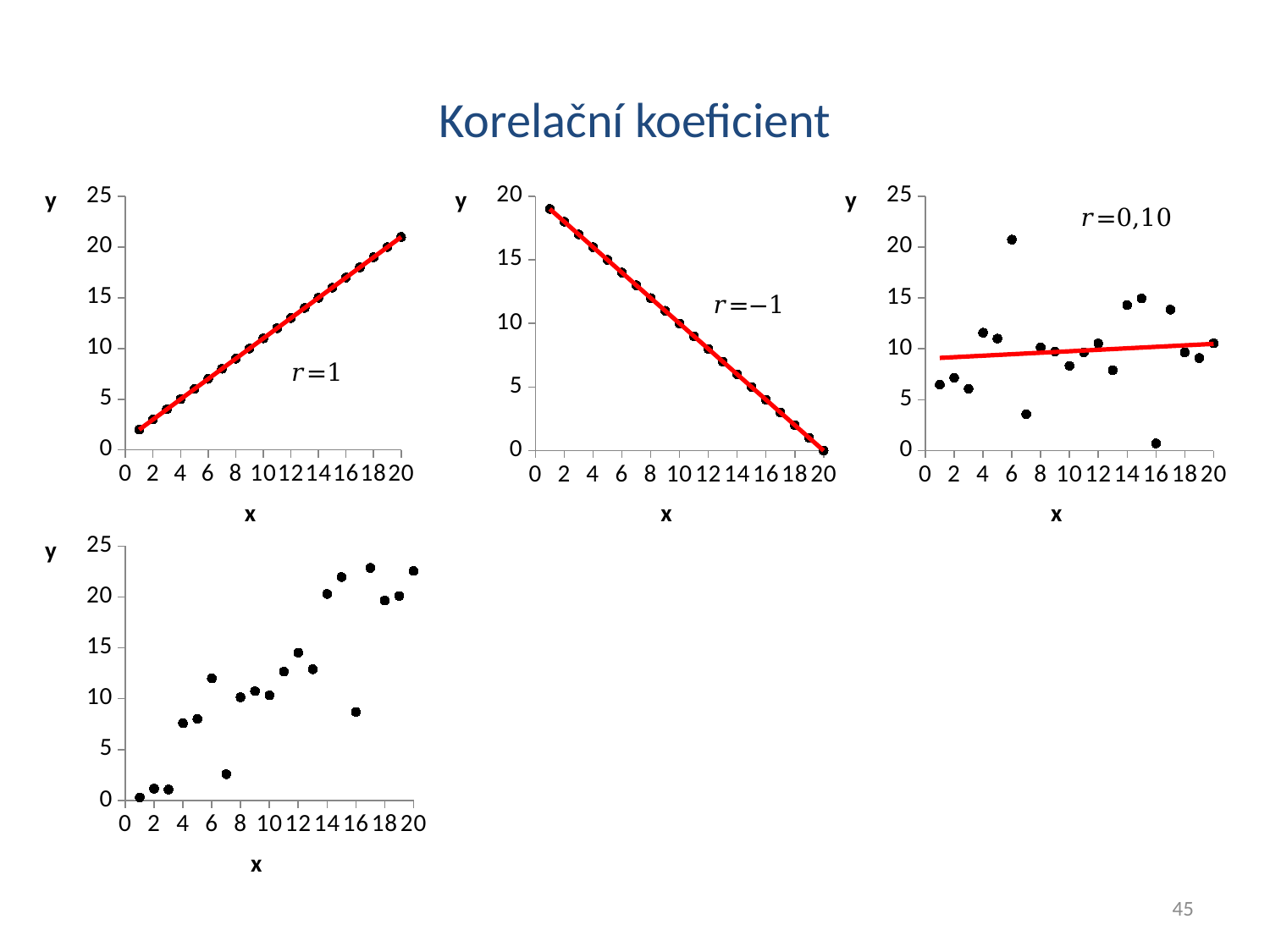
What correlation coefficient is annotated on the top-middle chart? r=−1 In the top-left chart (labelled r=1), do the y values rise or fall as x increases? rise In the bottom-left chart, is the y value at x=17 greater or less than 20? greater In the top-right chart (labelled r=0,10), is the y value at x=6 greater or less than 15? greater In the top-right chart (labelled r=0,10), at which x value is y lowest? 16 In the bottom-left chart, is the y value at x=16 greater or less than 15? less What kind of chart is the top-left chart (labelled r=1)? scatter chart In the top-middle chart (labelled r=−1), do the y values rise or fall as x increases? fall In the bottom-left chart, which has the larger y value: the point at x=6 or the point at x=7? x=6 What correlation coefficient is annotated on the top-right chart? r=0,10 In the top-right chart (labelled r=0,10), at which x value is y highest? 6 In the bottom-left chart, do the y values generally rise or fall as x increases? rise